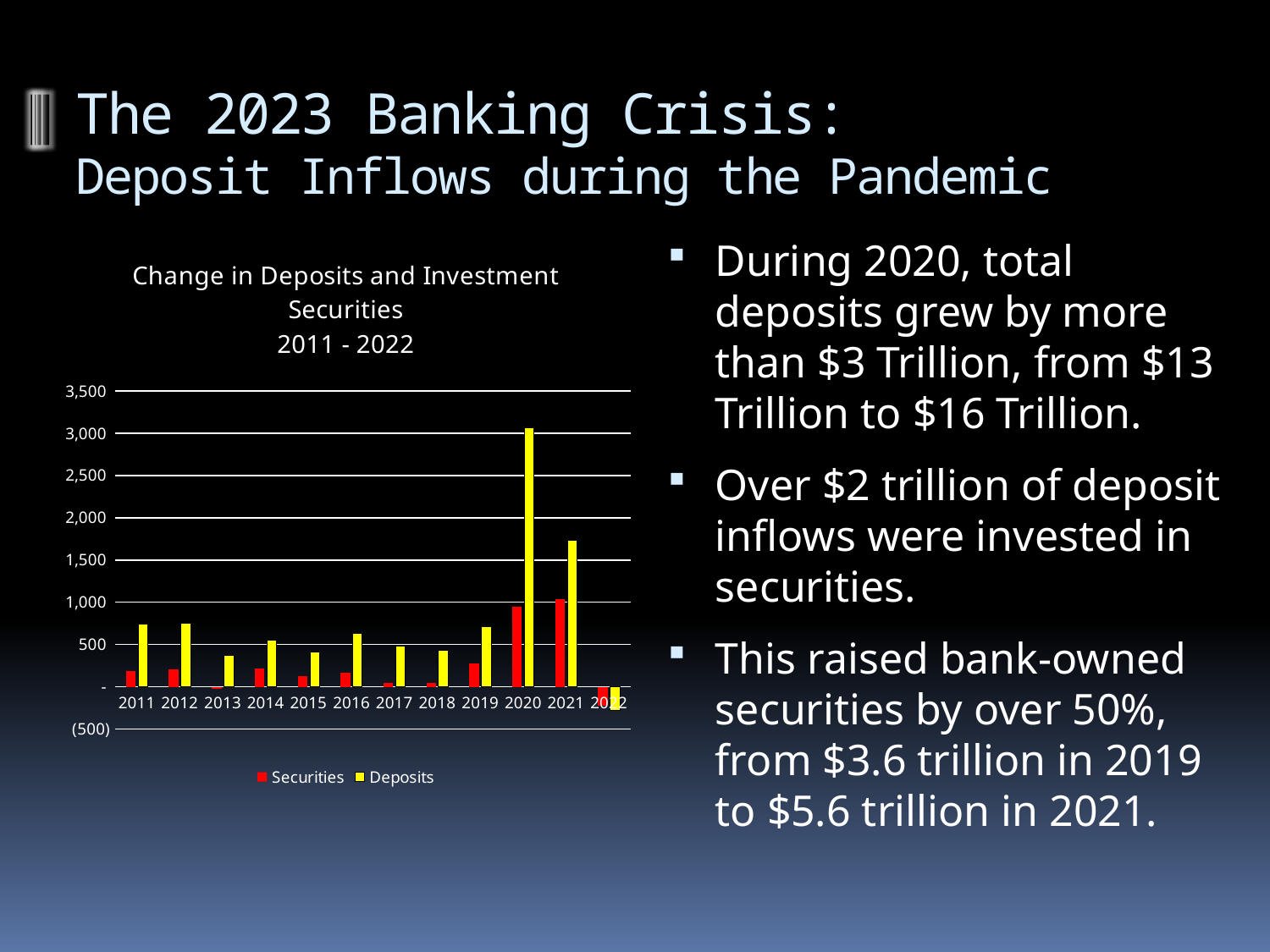
How many series does the chart legend list? 2 In which year is the Deposits value lowest? 2022 In which year is the Deposits value highest? 2020 Is the Deposits value for 2021 greater or less than 1,500? greater Is the Securities value for 2017 greater or less than 500? less Do the Deposits values rise or fall from 2017 to 2020? rise In 2020, which is larger, the Deposits value or the Securities value? Deposits Is the Deposits value for 2020 greater or less than 2,500? greater How many years are shown on the x axis of the chart? 12 What kind of chart is shown on the slide? bar chart Which colour represents the Securities series in the chart? red